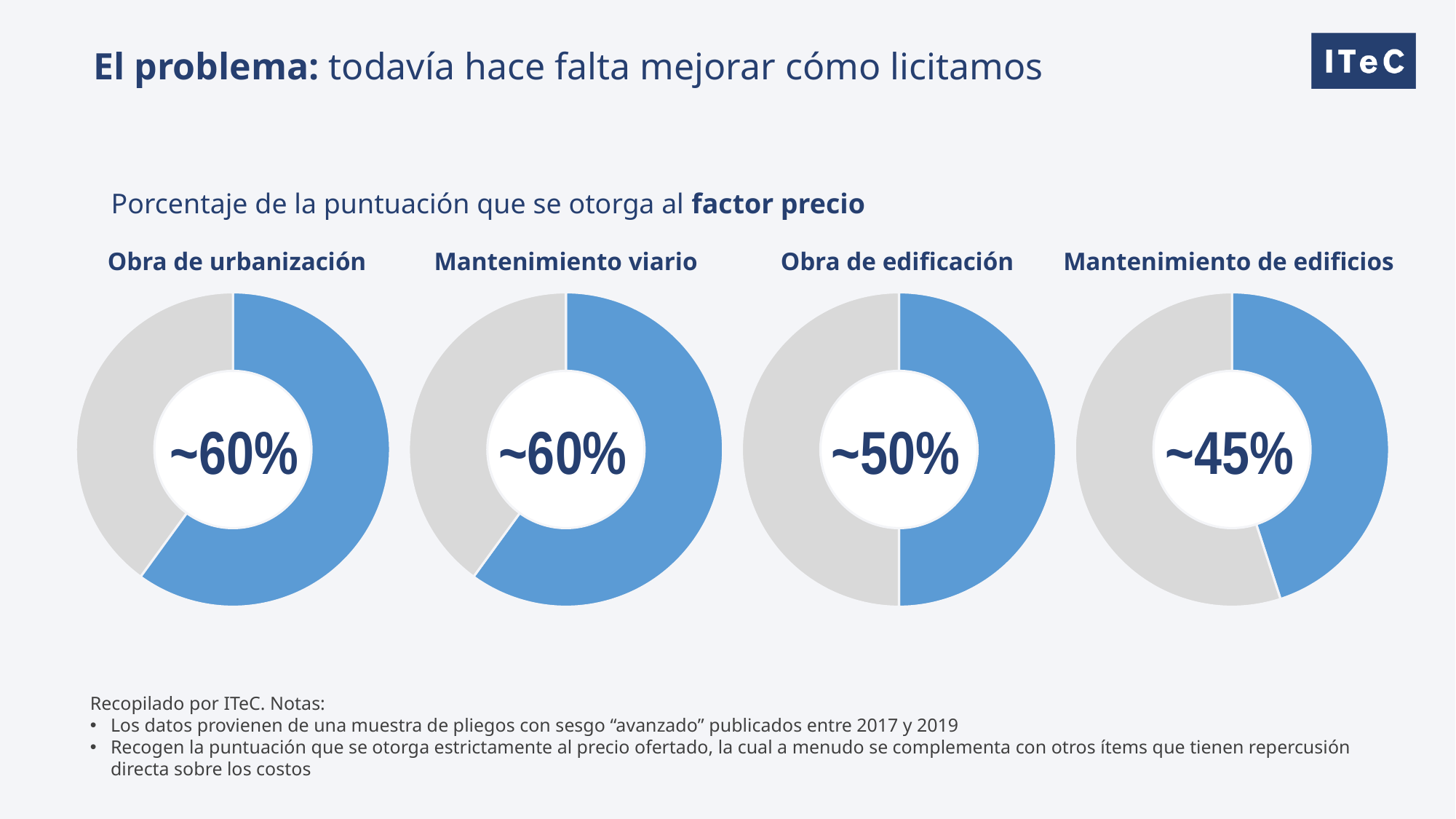
Which category has the lowest percentage of the score given to the price factor? Mantenimiento de edificios What is the title above the four donut charts? Porcentaje de la puntuación que se otorga al factor precio What value is printed in the centre of the 'Obra de urbanización' donut chart? ~60% What value is printed in the centre of the 'Mantenimiento de edificios' donut chart? ~45% What colour is used for the filled (price factor) portion of each donut chart? Blue Which two categories share the same printed value of ~60%? Obra de urbanización and Mantenimiento viario Which is larger: the value for 'Mantenimiento viario' or the value for 'Obra de edificación'? Mantenimiento viario What kind of chart is used to show the percentage of the score given to the price factor? Donut (pie) chart How many donut charts are shown on the slide? 4 What value is printed in the centre of the 'Mantenimiento viario' donut chart? ~60% Which is larger: the value for 'Obra de urbanización' or the value for 'Mantenimiento de edificios'? Obra de urbanización What value is printed in the centre of the 'Obra de edificación' donut chart? ~50%